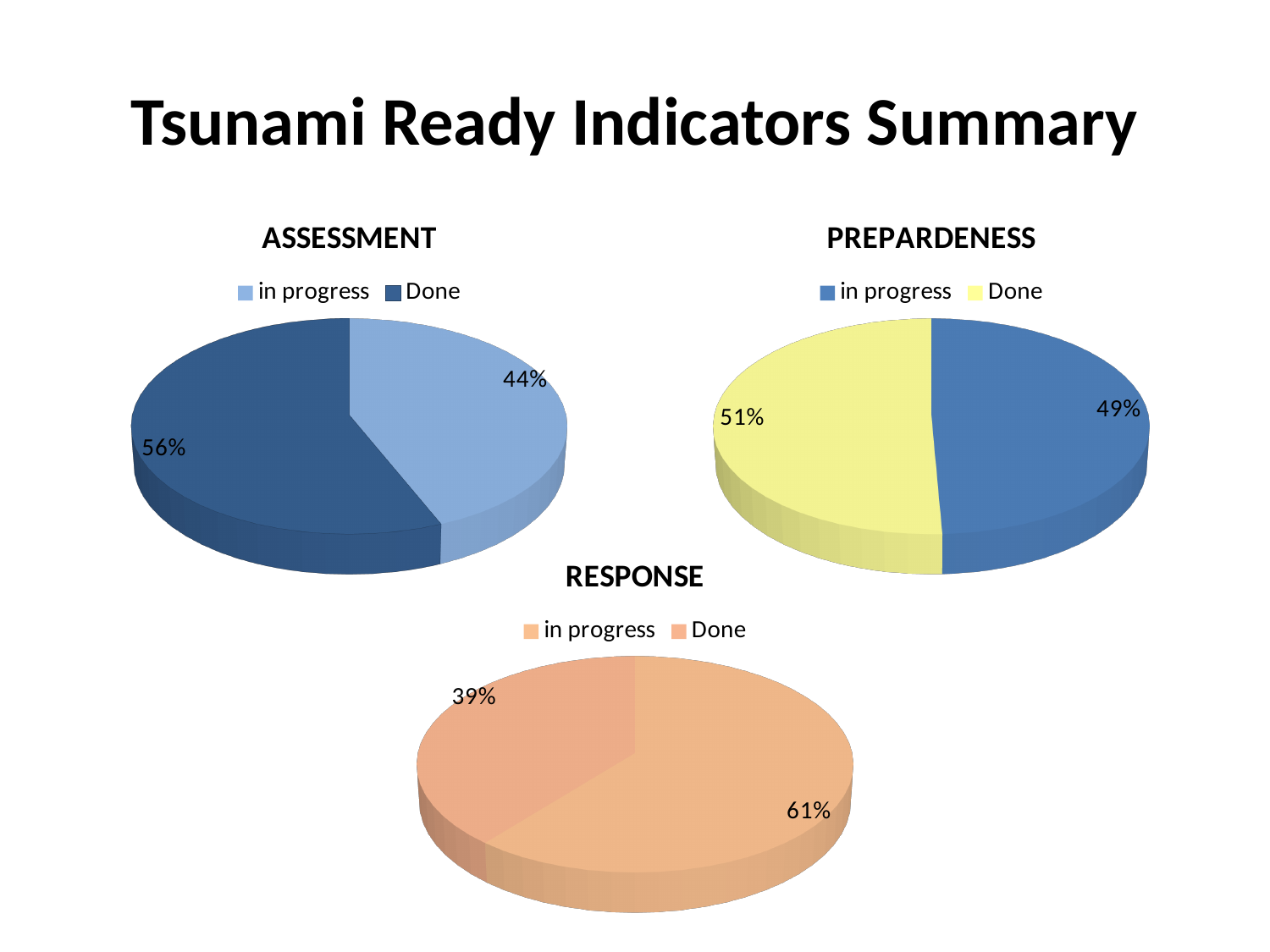
How many pie charts are shown on the slide? 3 In the ASSESSMENT chart, what percentage is labelled in progress? 44% In the ASSESSMENT chart, what percentage is labelled Done? 56% In the RESPONSE chart, what is the difference between the two slice values? 22% In the PREPARDENESS chart, what percentage is labelled in progress? 49% In the RESPONSE chart, what is the value of the largest slice? 61% In the ASSESSMENT chart, what is the difference between the Done and in progress percentages? 12% How many entries does the legend of the PREPARDENESS chart list? 2 In the ASSESSMENT chart, which slice is larger, in progress or Done? Done In the RESPONSE chart, what is the value of the smallest slice? 39% What kind of chart is the RESPONSE chart? Pie chart In the PREPARDENESS chart, what percentage is labelled Done? 51%